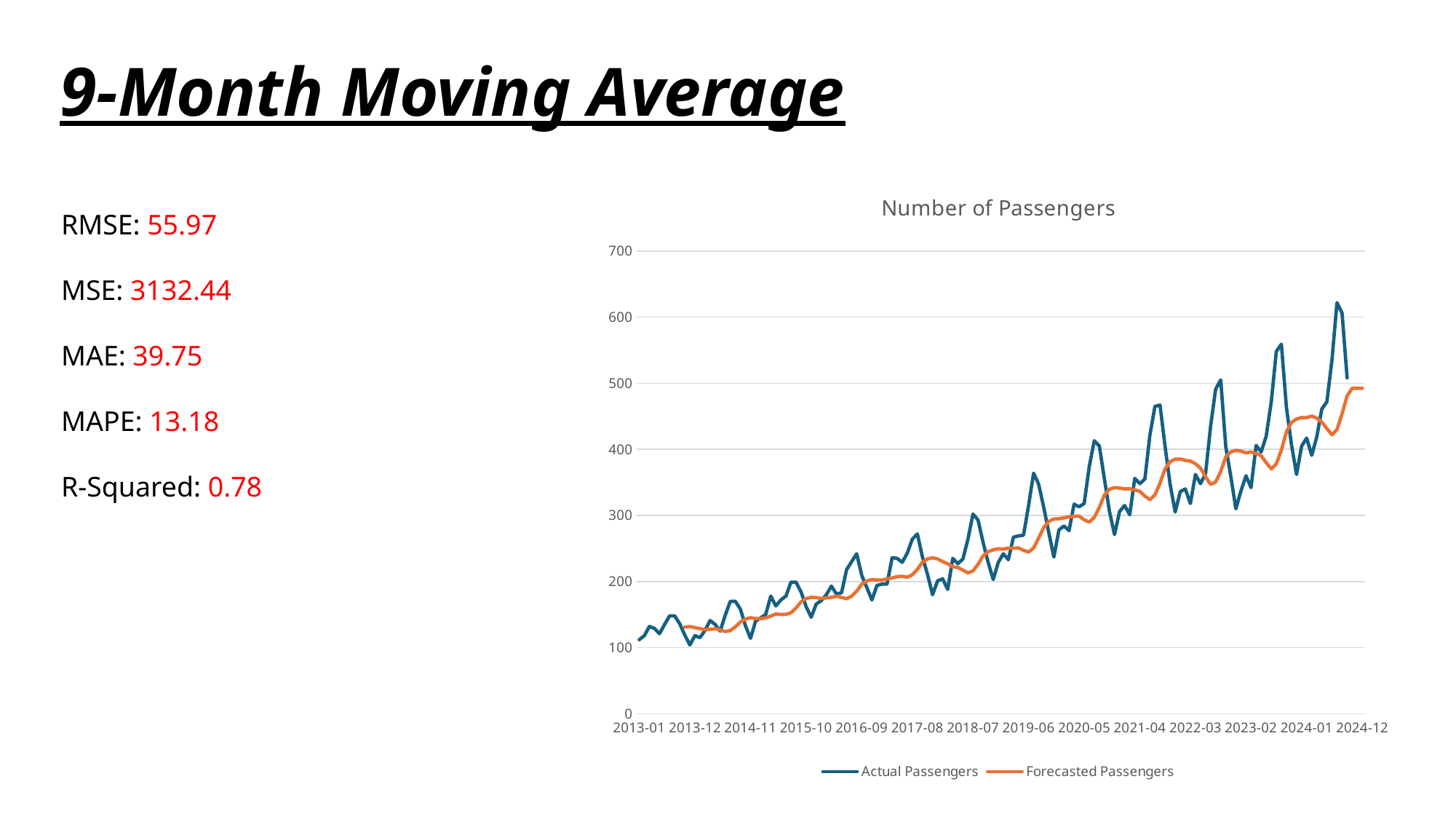
How many date labels are shown along the x axis of the chart? 14 Which series reaches the highest value on the chart, Actual Passengers or Forecasted Passengers? Actual Passengers How many series does the chart legend list? 2 Do the Actual Passengers values generally rise or fall from 2013-01 to 2024-12? rise What are the two series named in the chart legend? Actual Passengers and Forecasted Passengers Is the Actual Passengers value at 2013-01 greater or less than 200? less What is the title of the chart? Number of Passengers What is the highest value shown on the chart's y axis? 700 Is the highest value of the Forecasted Passengers series greater or less than 500? less Is the highest value of the Actual Passengers series greater or less than 600? greater Does the Forecasted Passengers line generally rise or fall along the x axis? rise What kind of chart is shown on the slide? line chart